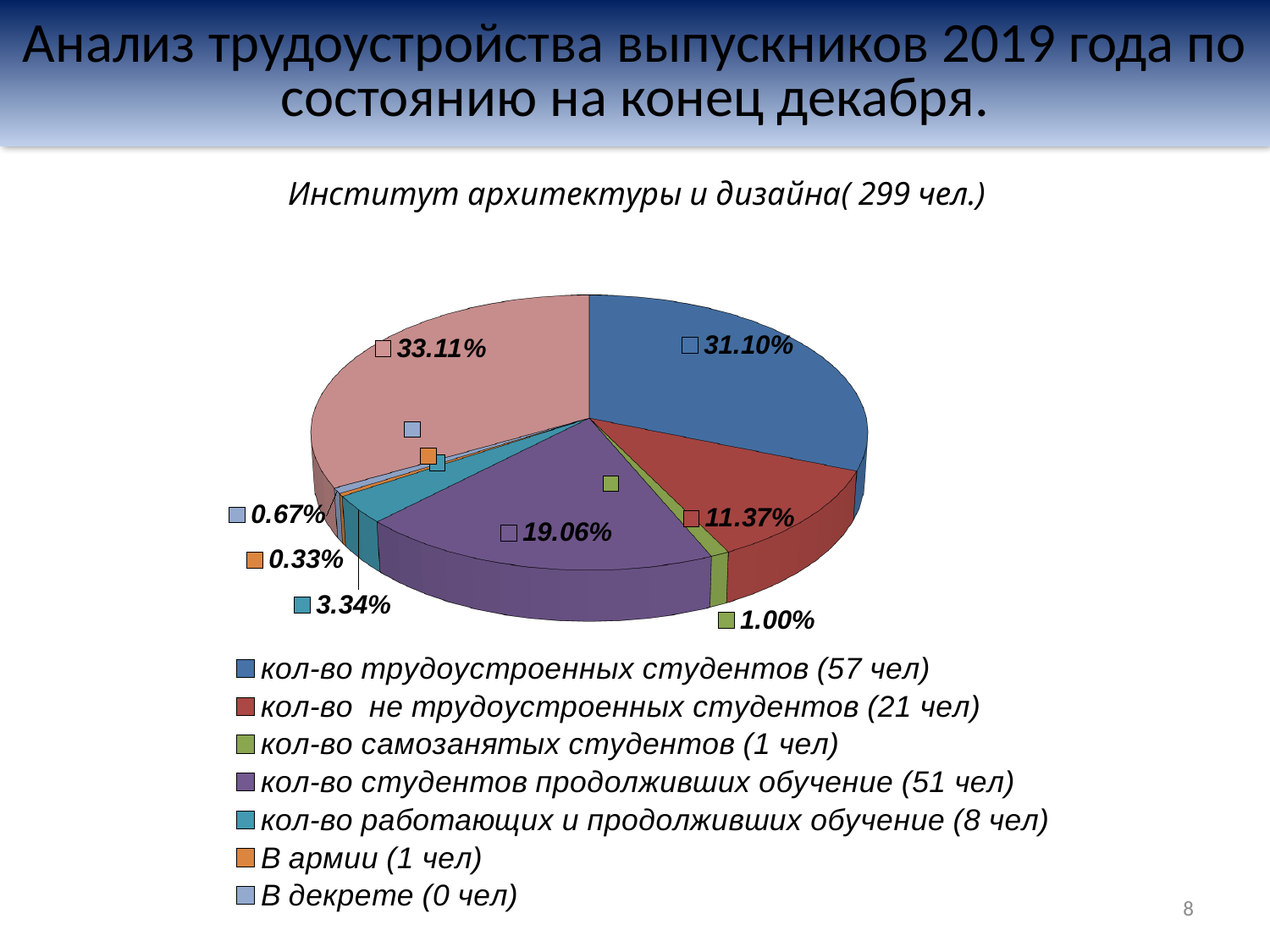
Which is larger: the share of employed students (трудоустроенных) or the share of students who continued their education (продолживших обучение)? кол-во трудоустроенных студентов What percentage is shown for "кол-во самозанятых студентов"? 1.00% What percentage is shown for "кол-во работающих и продолживших обучение"? 3.34% What percentage is shown for "кол-во не трудоустроенных студентов"? 11.37% What percentage is shown for "В армии"? 0.33% What type of chart is shown on the slide? pie chart What percentage is shown for "кол-во студентов продолживших обучение"? 19.06% According to the legend, how many students are in the "кол-во трудоустроенных студентов" category? 57 чел What is the difference in percentage points between the employed students slice (31.10%) and the not employed students slice (11.37%)? 19.73% How many entries does the legend list? 7 What is the largest percentage label shown on the pie chart? 33.11% What percentage of the pie corresponds to "кол-во трудоустроенных студентов"? 31.10%